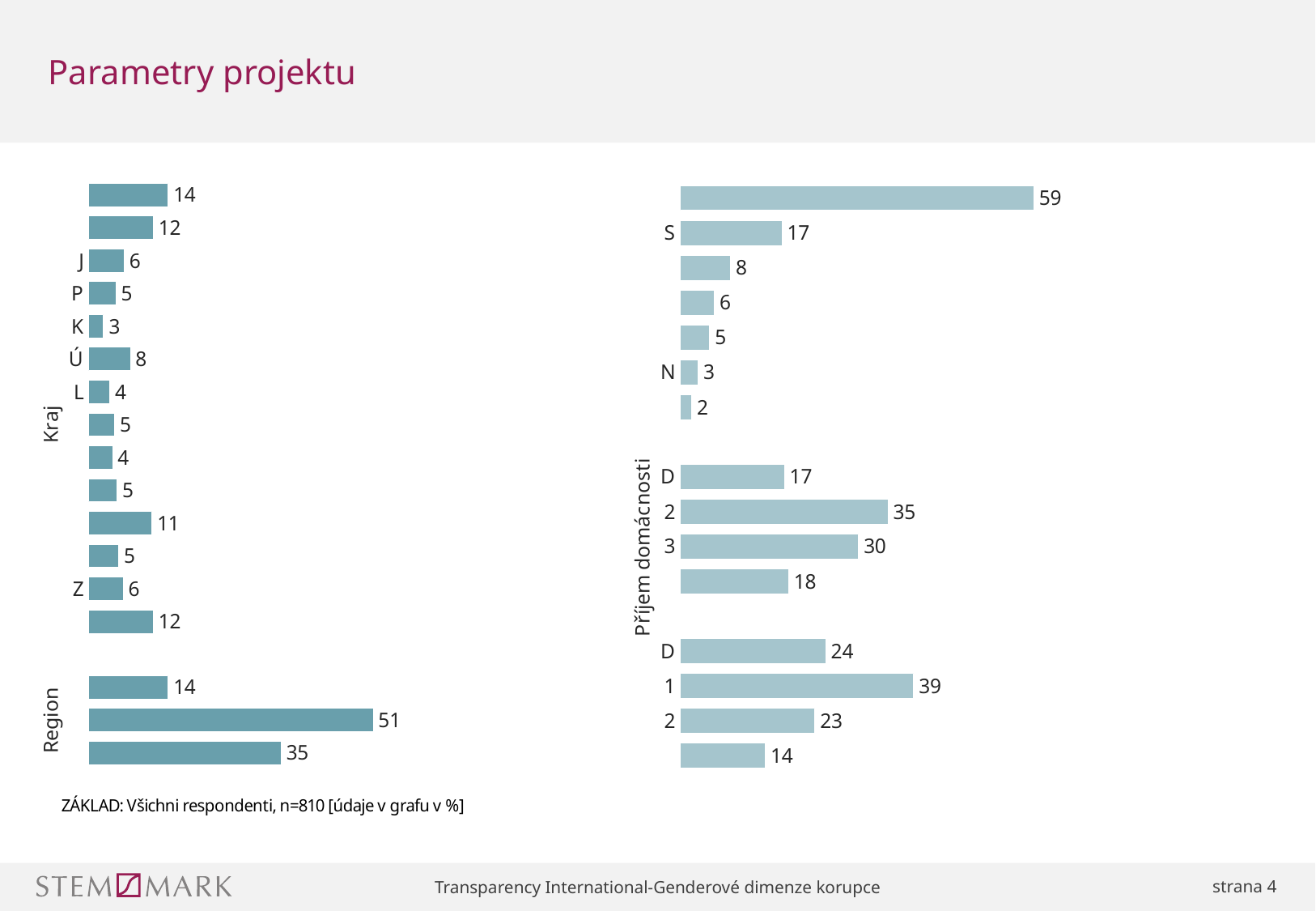
In the right chart (Příjem domácnosti), what is the largest value shown? 59 In the left chart (Kraj/Region), what is the value for category Ú? 8 In the left chart, how many bars are in the Region group? 3 In the left chart (Kraj/Region), what is the largest value shown? 51 In the left chart (Kraj/Region), which has the larger value, J or L? J In the left chart (Kraj/Region), what is the difference between the values for Ú and K? 5 In the right chart (Příjem domácnosti), what is the value for category 1? 39 In the left chart (Kraj/Region), what is the value for category K? 3 In the right chart (Příjem domácnosti), what is the value for category S? 17 In the right chart (Příjem domácnosti), what is the value for category N? 3 In the right chart (Příjem domácnosti), what is the smallest value shown? 2 What type of chart is used on this slide? Bar chart